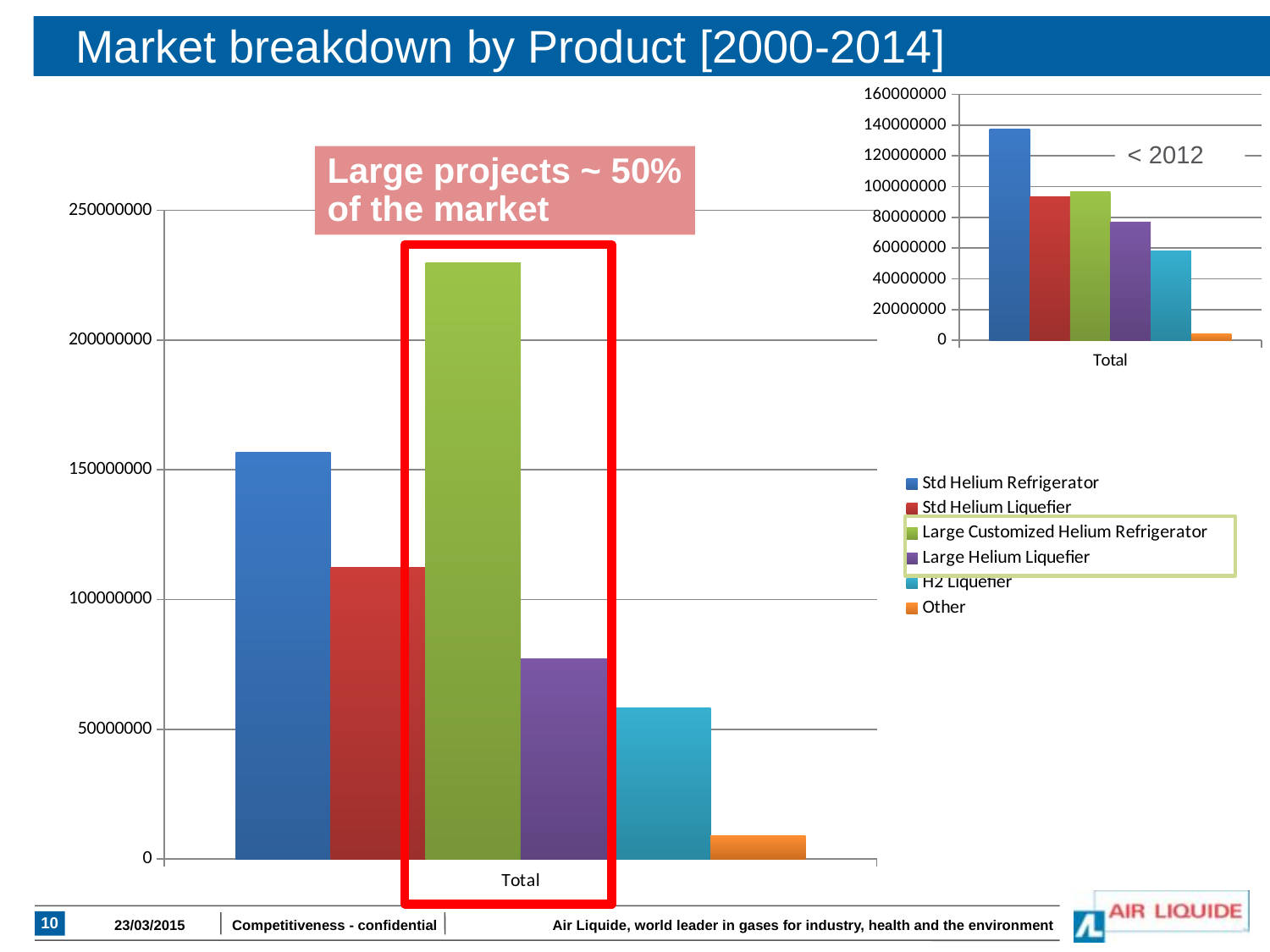
In the large chart on the left, is the value for Large Customized Helium Refrigerator greater or less than 200000000? greater In the small chart at the top right (< 2012), is the value for Std Helium Refrigerator greater or less than 120000000? greater What is the title of the slide containing the charts? Market breakdown by Product [2000-2014] In the large chart on the left, is the value for H2 Liquefier greater or less than 100000000? less In the large chart on the left, which is larger: Std Helium Liquefier or Large Helium Liquefier? Std Helium Liquefier In the large chart on the left, which series has the lowest value? Other What kind of chart is the large chart on the left of the slide? bar chart How many series does the legend of the large chart list? 6 In the small chart at the top right (< 2012), which is larger: Large Helium Liquefier or H2 Liquefier? Large Helium Liquefier In the large chart on the left, which series has the highest value? Large Customized Helium Refrigerator In the small chart at the top right (< 2012), which series has the highest value? Std Helium Refrigerator